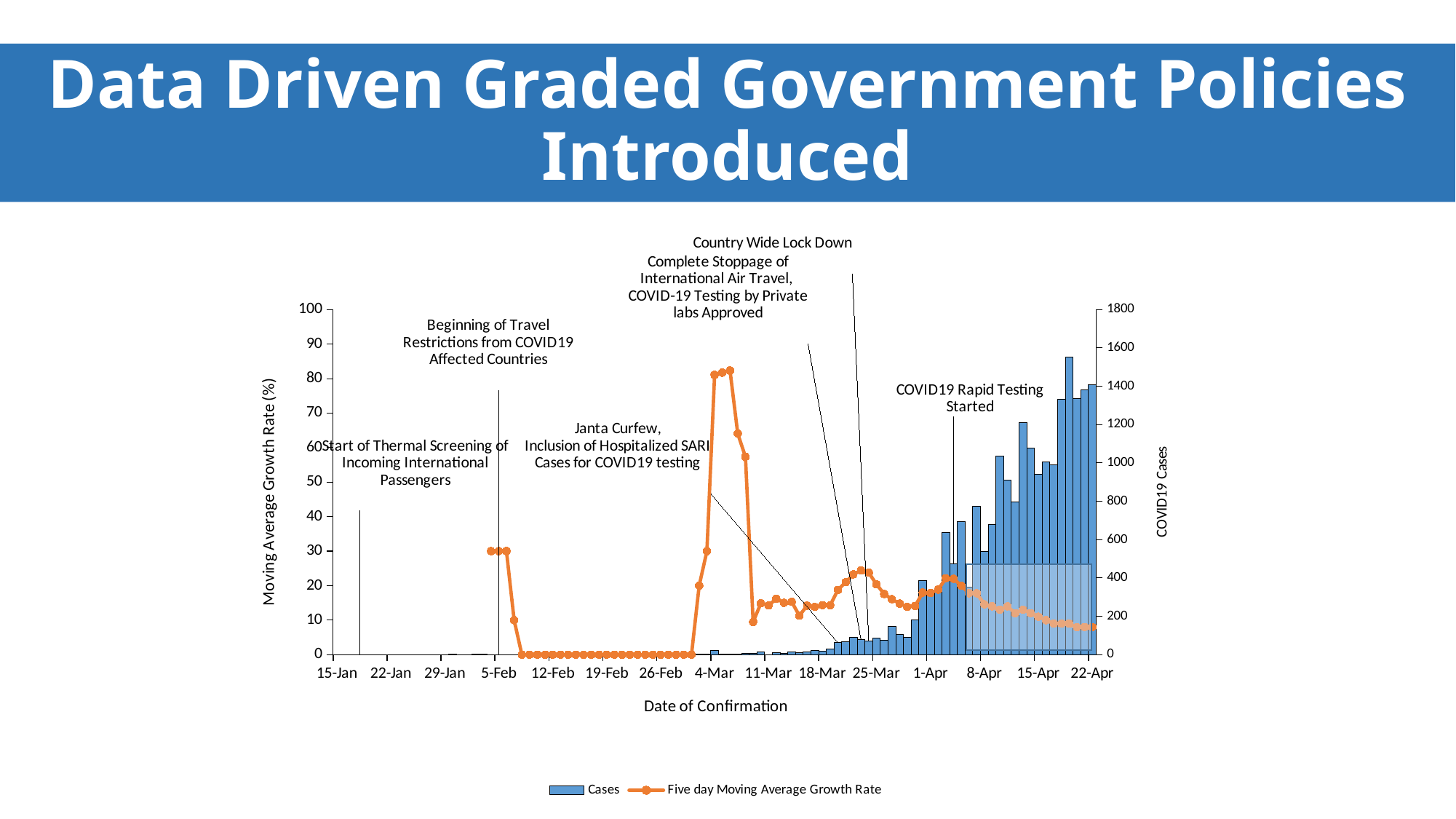
Does the highest Cases bar occur before or after 15-Apr? after What is the title of the x axis? Date of Confirmation Is the Five day Moving Average Growth Rate on 5-Feb greater or less than 20? greater What kind of chart is shown on the slide? A combined bar and line chart Which series is drawn as bars? Cases Is the peak value of the Five day Moving Average Growth Rate around 4-Mar greater or less than 70? greater Does the Five day Moving Average Growth Rate rise or fall between 4-Mar and 11-Mar? fall Do the Cases bars generally rise or fall from 18-Mar to 22-Apr? rise How many series does the legend list? 2 Is the highest Cases bar greater or less than 1400 on the right axis? greater Which is larger, the Five day Moving Average Growth Rate on 4-Mar or on 25-Mar? 4-Mar